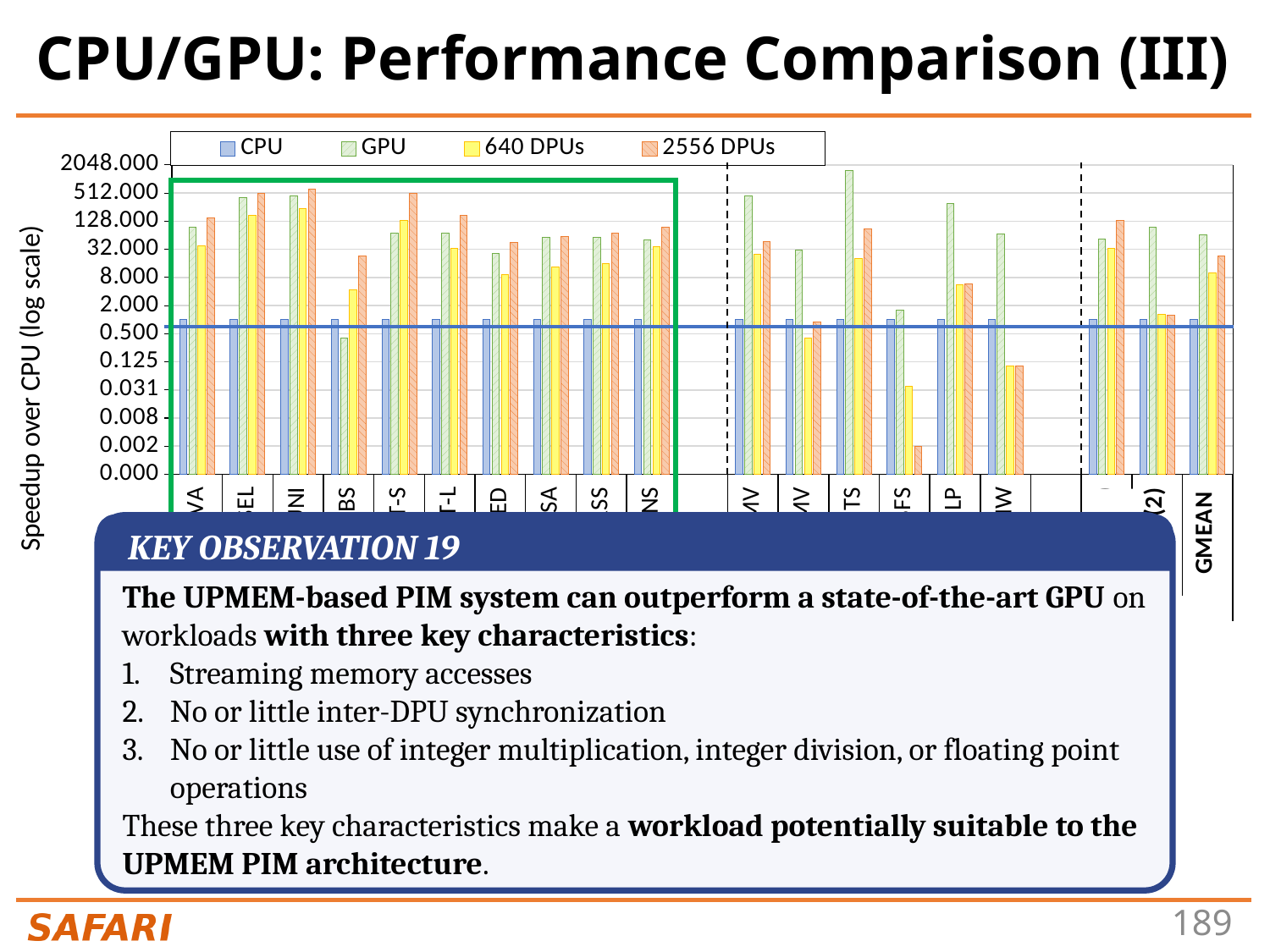
Is the 2556 DPUs value for LP greater or less than 32.000? less For GMEAN, which is larger: the GPU value or the 2556 DPUs value? GPU Is the GPU value for TS greater or less than 512.000? greater Is the 640 DPUs value for GMEAN greater or less than 32.000? less How many series does the legend list? 4 Which series are listed in the legend? CPU, GPU, 640 DPUs, 2556 DPUs What is the label of the y-axis? Speedup over CPU (log scale) What kind of chart is shown on the slide? bar chart For BS, which is larger: the GPU value or the 640 DPUs value? 640 DPUs